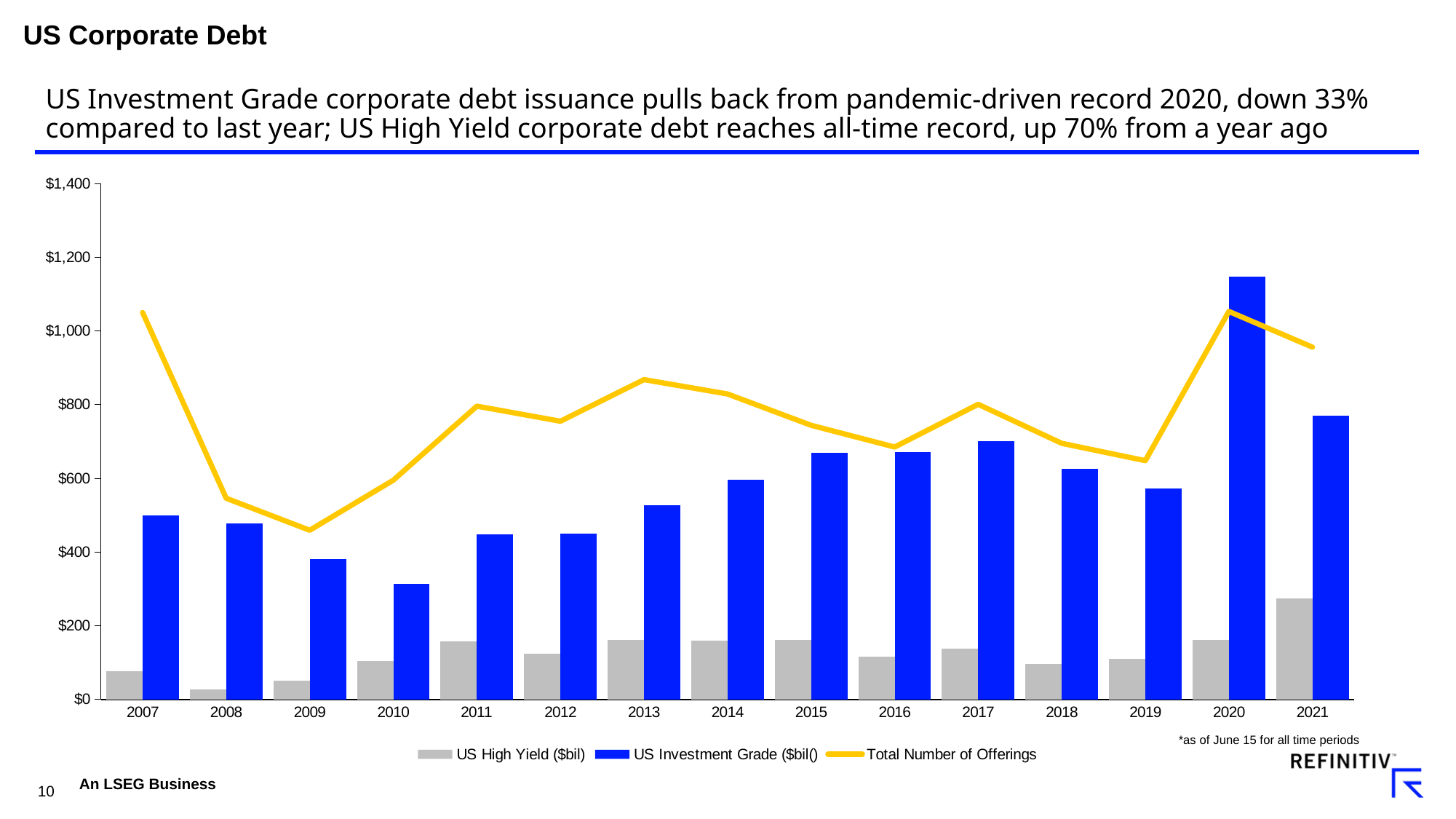
In which year is the Total Number of Offerings line at its lowest point? 2009 How many years are shown on the x axis? 15 Which year has the larger US Investment Grade value, 2019 or 2021? 2021 Is the US Investment Grade value for 2020 greater or less than $1,000? greater In which year is US High Yield ($bil) highest? 2021 In which year is US Investment Grade ($bil) lowest? 2010 Is the US Investment Grade value for 2010 greater or less than $400? less In which year is US Investment Grade ($bil) highest? 2020 Is the US High Yield value for 2021 greater or less than $200? greater In which year is US High Yield ($bil) lowest? 2008 How many series does the legend list? 3 What kind of chart is shown on the slide? A bar chart with a line series